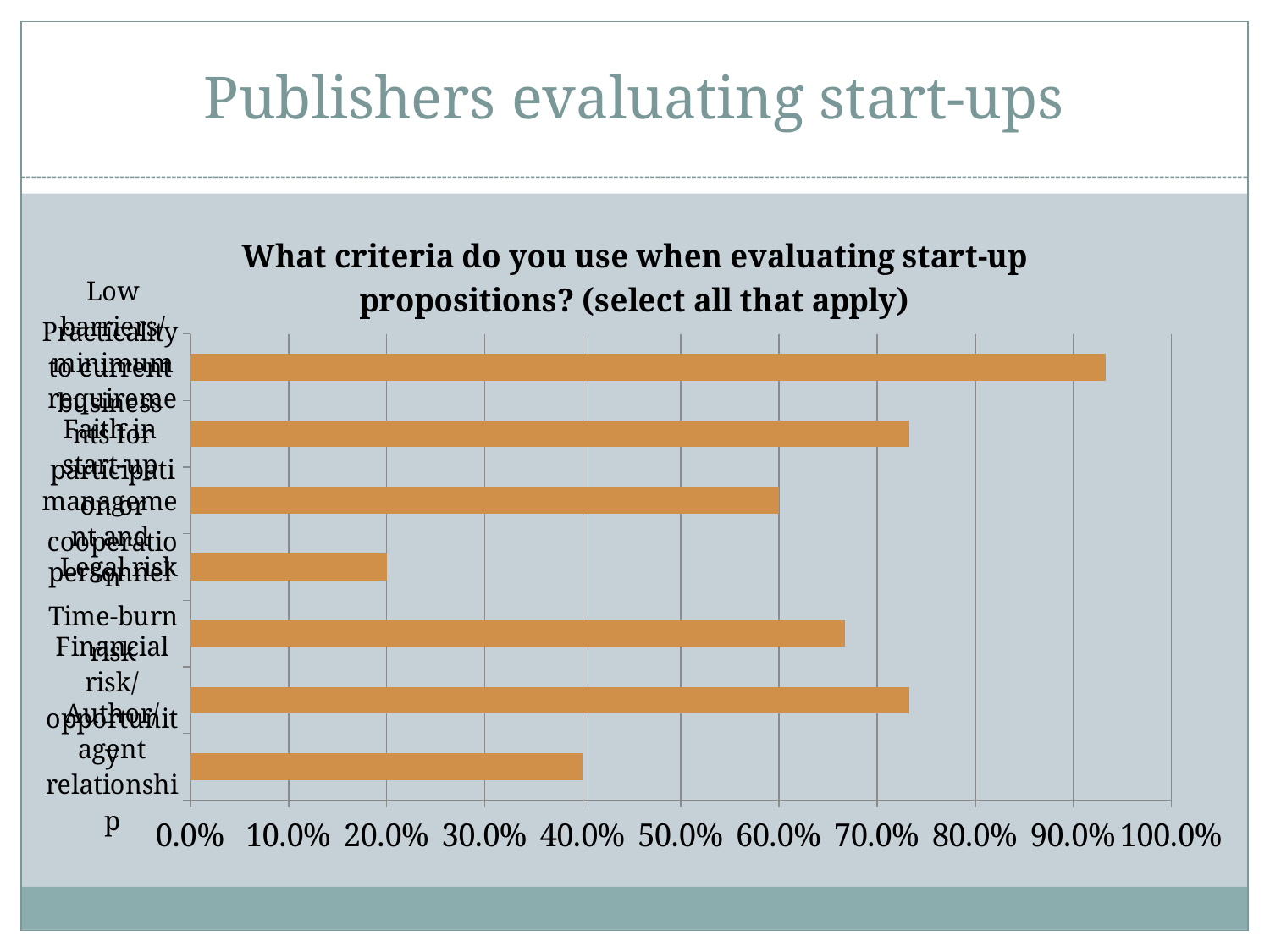
How many bars are plotted in the chart? 7 Is the value for Time-burn risk greater or less than 60.0%? greater Which is larger, the value for Time-burn risk or the value for Author/agent relationship? Time-burn risk What is the title of the chart? What criteria do you use when evaluating start-up propositions? (select all that apply) What is the value for Legal risk? 20.0% What is the value for Author/agent relationship? 40.0% Is the longest bar in the chart greater or less than 90.0%? greater Which is larger, the value for Legal risk or the value for Author/agent relationship? Author/agent relationship What kind of chart is shown on the slide? bar chart What is the difference between the value for Author/agent relationship and the value for Legal risk? 20.0% Is the value for Legal risk greater or less than 30.0%? less Which category has the lowest value? Legal risk